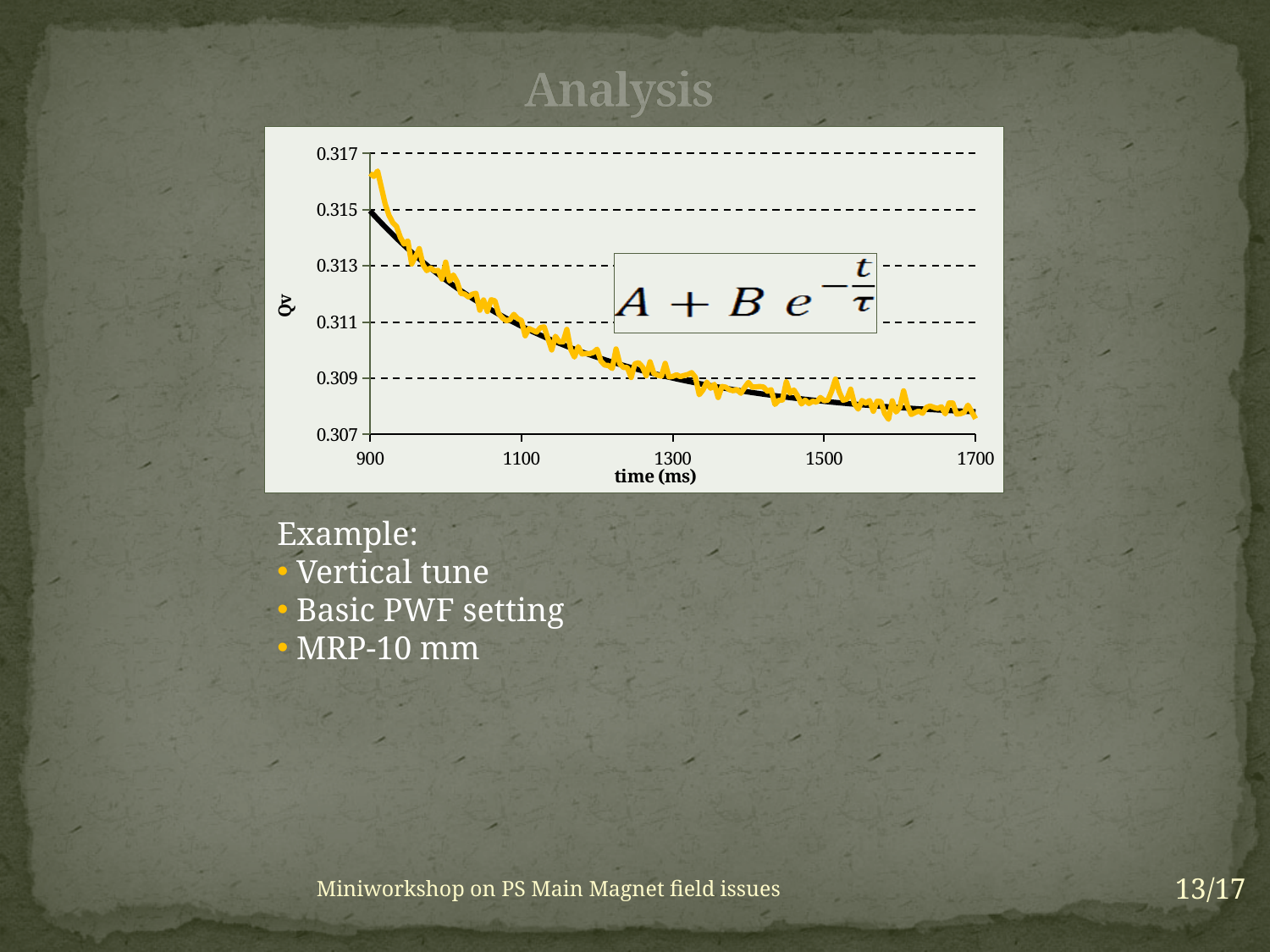
Is the Qv value at time 1100 ms greater or less than 0.309? greater Is the Qv value at time 1700 ms greater or less than 0.309? less What kind of chart is shown on the slide? line chart Is the Qv value at time 1500 ms greater or less than 0.309? less Does the plotted Qv value rise or fall as time increases from 900 ms to 1700 ms? fall What is the label of the x axis of the chart? time (ms) What is the label of the y axis of the chart? Qv Which has the higher Qv value, time 900 ms or time 1700 ms? 900 ms How many lines are plotted on the chart? 2